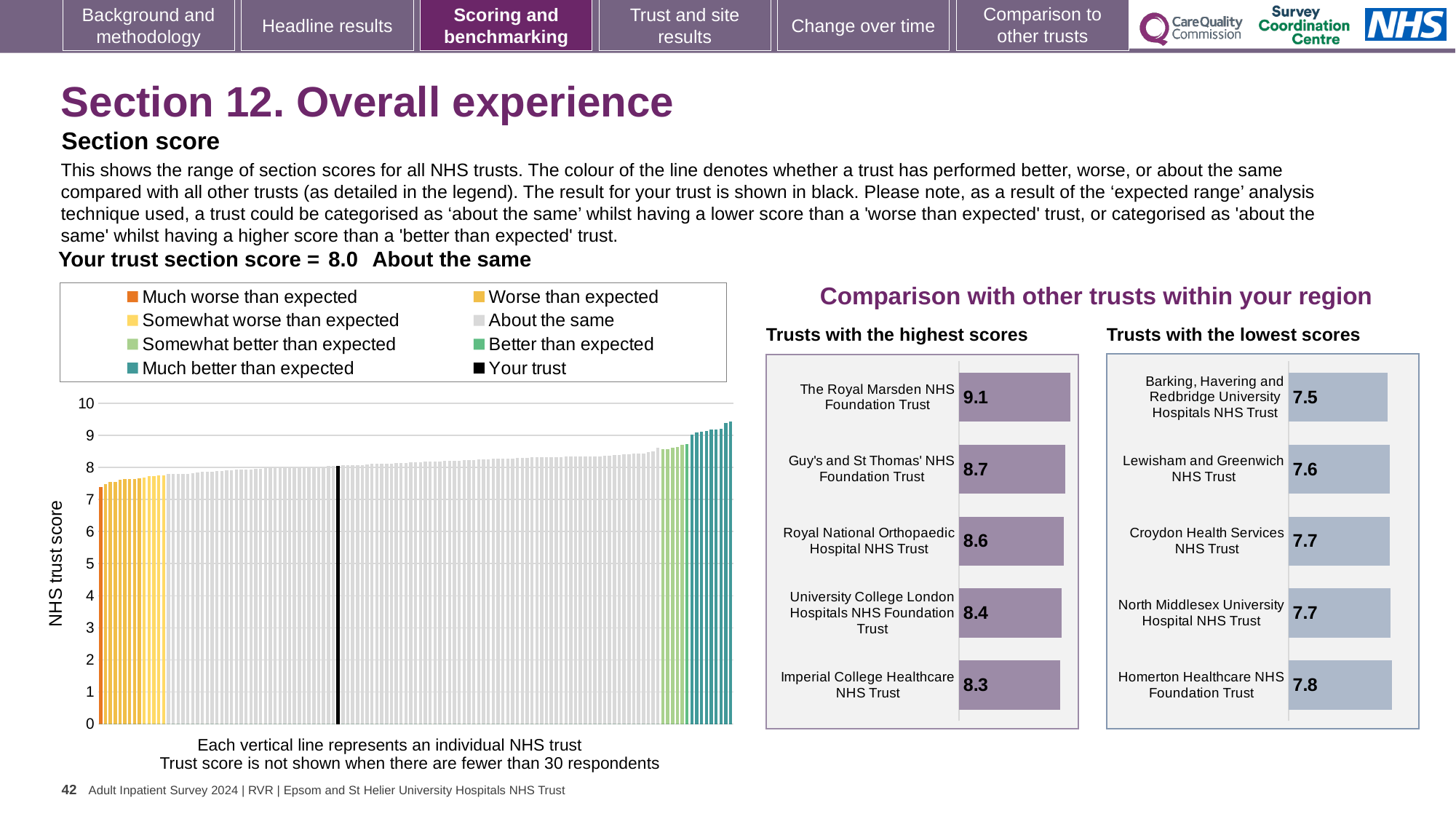
What kind of chart is the main chart showing the range of section scores for all NHS trusts? bar chart How many trusts are shown in the 'Trusts with the highest scores' chart? 5 In the 'Trusts with the lowest scores' chart, what is the difference between the scores of Homerton Healthcare NHS Foundation Trust and Barking, Havering and Redbridge University Hospitals NHS Trust? 0.3 In the 'Trusts with the lowest scores' chart, which trust has the lowest score? Barking, Havering and Redbridge University Hospitals NHS Trust In the 'Trusts with the highest scores' chart, which trust has the highest score? The Royal Marsden NHS Foundation Trust In the 'Trusts with the highest scores' chart, what is the score for The Royal Marsden NHS Foundation Trust? 9.1 In the main 'NHS trust score' chart, what is the section score for your trust (the black bar)? 8.0 How many entries does the legend of the main 'NHS trust score' chart list? 8 In the main 'NHS trust score' chart, is the value of the tallest bar greater or less than 9? greater In the 'Trusts with the highest scores' chart, what is the difference between the scores of The Royal Marsden NHS Foundation Trust and Imperial College Healthcare NHS Trust? 0.8 In the 'Trusts with the highest scores' chart, which has the higher score: Guy's and St Thomas' NHS Foundation Trust or Royal National Orthopaedic Hospital NHS Trust? Guy's and St Thomas' NHS Foundation Trust In the 'Trusts with the lowest scores' chart, what is the score for Lewisham and Greenwich NHS Trust? 7.6